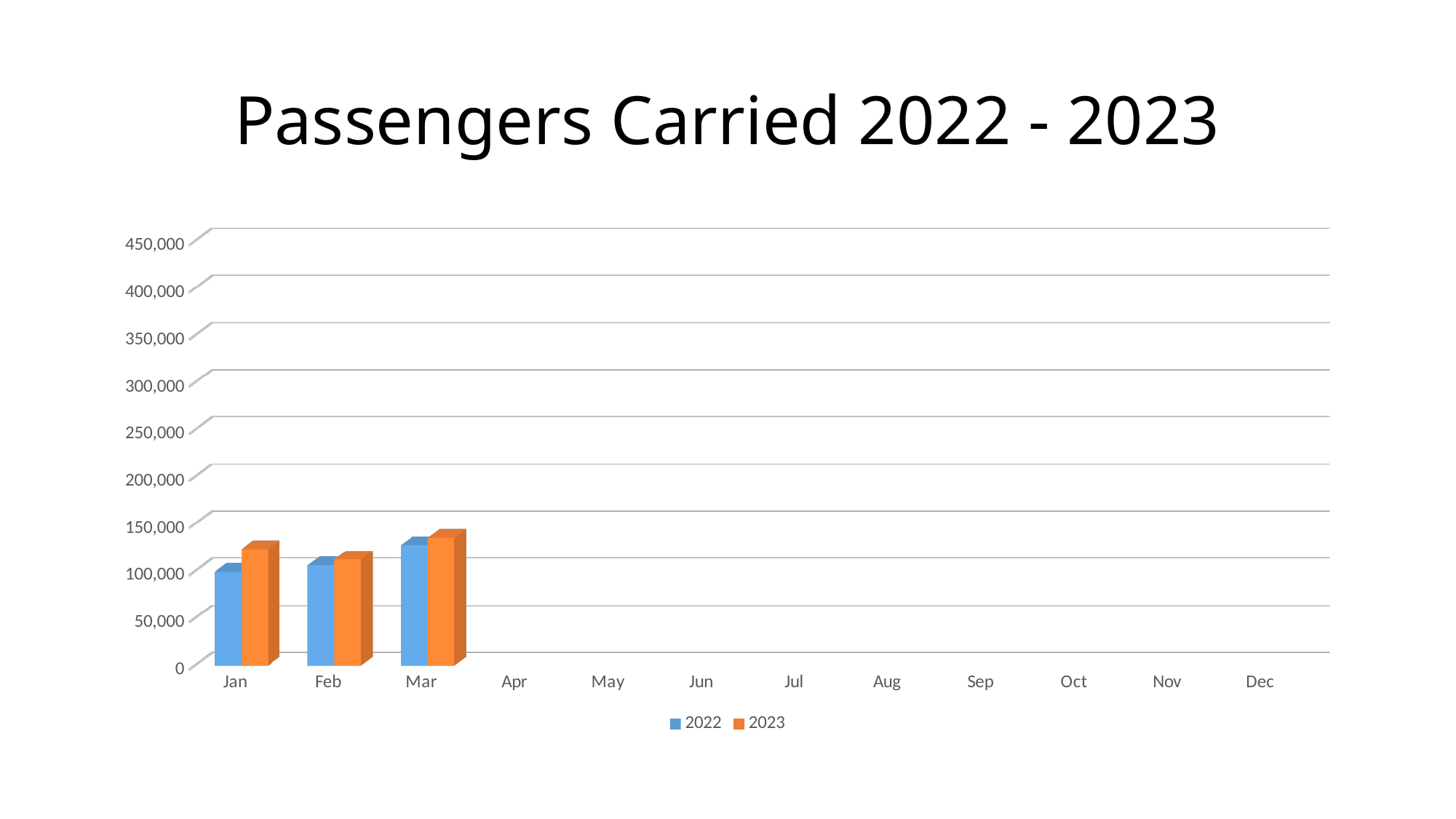
What is the title of the chart? Passengers Carried 2022 - 2023 Which month has the highest value for the 2023 series? Mar What kind of chart is shown on the slide? bar chart Which month has the lowest value for the 2022 series? Jan Do the 2022 values rise or fall from Jan to Mar? rise How many series does the legend list? 2 Which colour represents the 2023 series? orange Is the value for 2023 in Jan greater or less than 100,000? greater How many month categories are shown on the x axis? 12 Is the value for 2022 in Mar greater or less than 100,000? greater Which is larger in Jan, the 2022 value or the 2023 value? 2023 Is the value for 2023 in Mar greater or less than 150,000? less